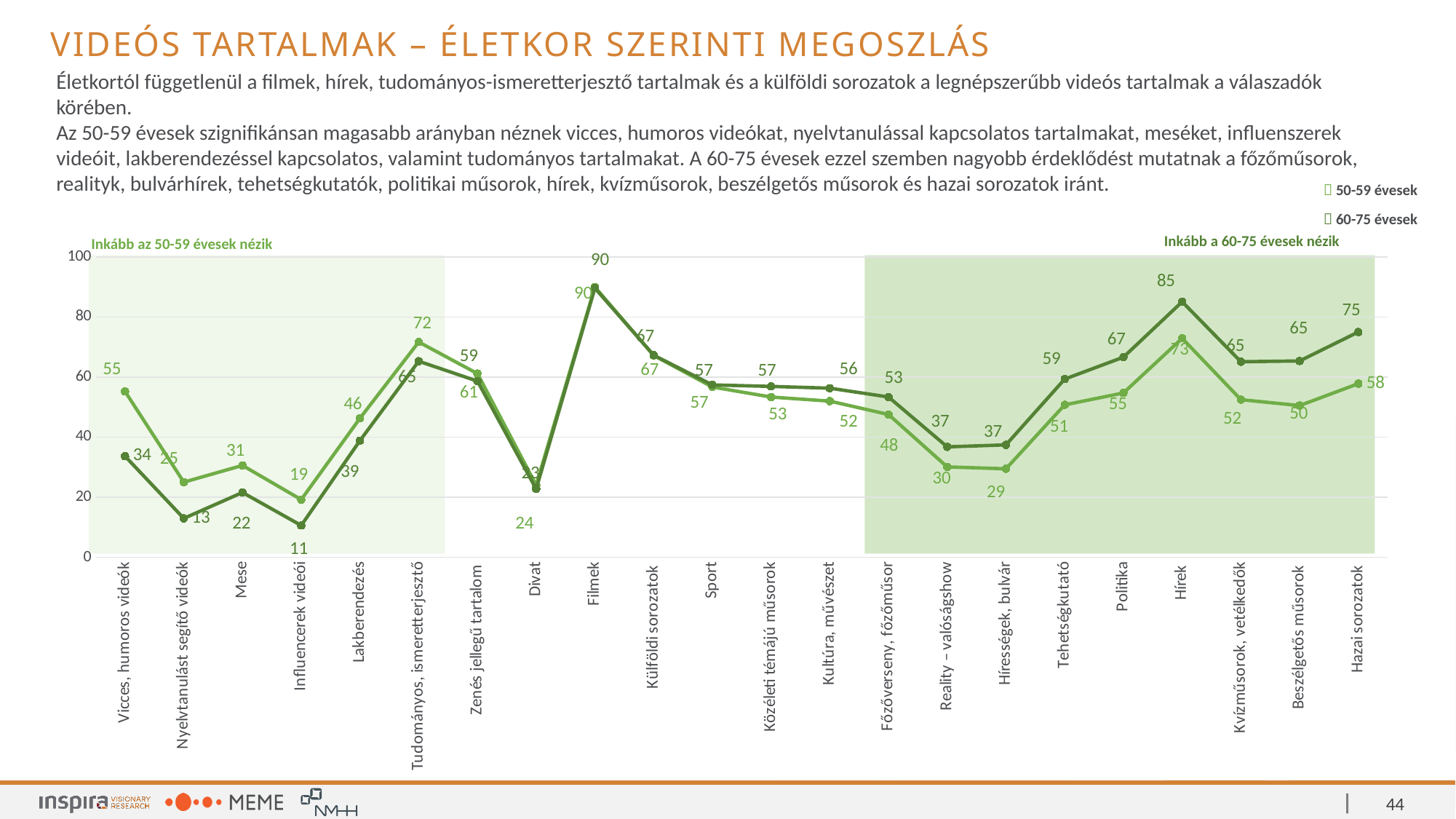
How many categories are shown on the x axis of the chart? 22 What is the difference between the 60-75 évesek and 50-59 évesek values for Beszélgetős műsorok? 15 How many series does the legend list? 2 What is the value for Hazai sorozatok in the 60-75 évesek series? 75 What kind of chart is shown on the slide? Line chart Which category has the highest value in the 50-59 évesek series? Filmek What is the value for Hírek in the 60-75 évesek series? 85 For Politika, which series has the larger value: 50-59 évesek or 60-75 évesek? 60-75 évesek For Tudományos, ismeretterjesztő, which series has the larger value: 50-59 évesek or 60-75 évesek? 50-59 évesek What is the value for Vicces, humoros videók in the 50-59 évesek series? 55 Which category has the lowest value in the 60-75 évesek series? Influencerek videói What is the difference between the 50-59 évesek and 60-75 évesek values for Vicces, humoros videók? 21